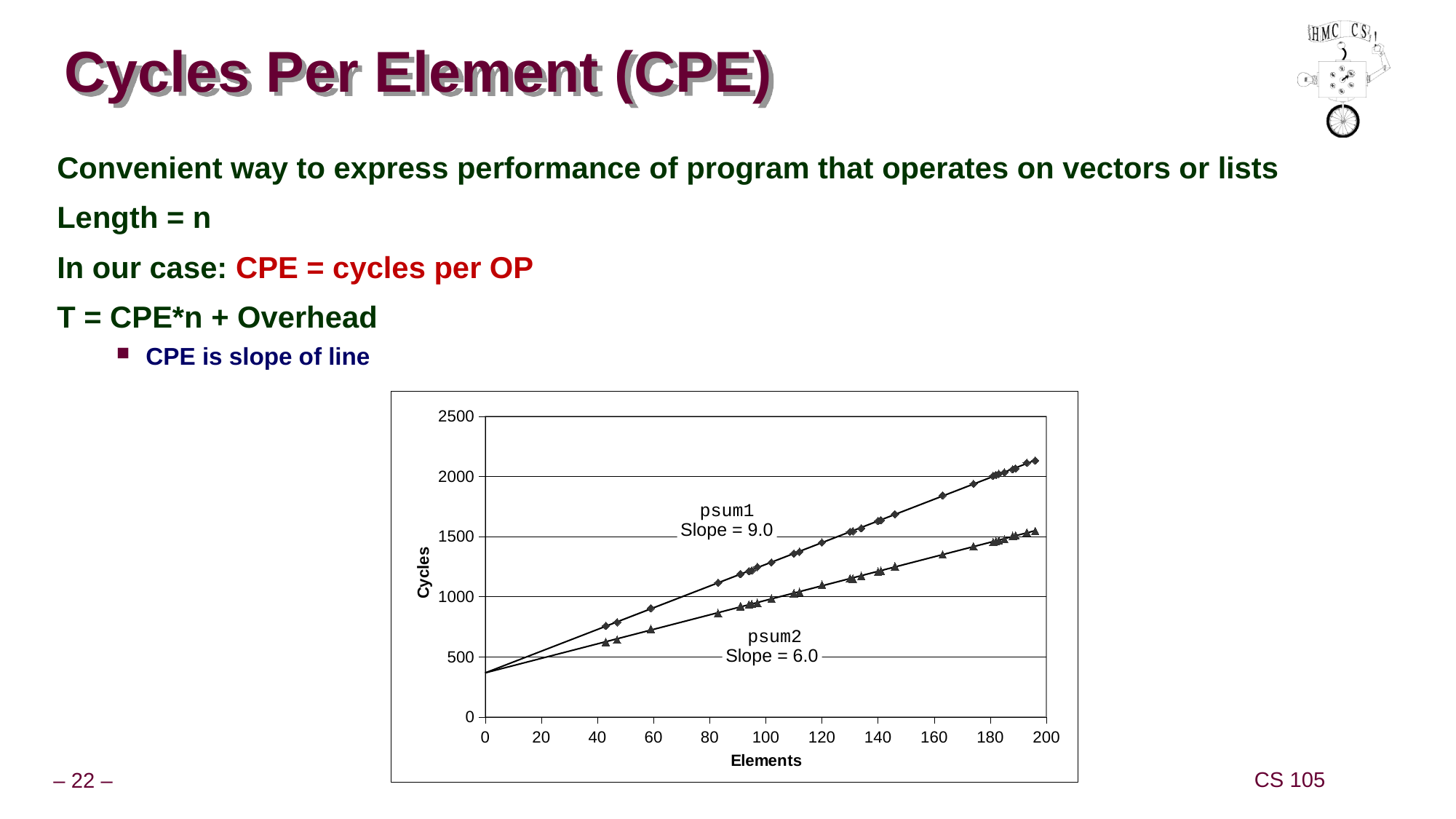
What is the difference between the printed slopes of psum1 and psum2? 3.0 What is the label on the y axis of the chart? Cycles What is the slope printed for the psum2 series? 6.0 What kind of chart is shown on the slide? scatter plot At 160 elements, which series has more cycles, psum1 or psum2? psum1 Do the cycle counts rise or fall as the number of elements increases? rise Which series has the larger slope, psum1 or psum2? psum1 How many data series are plotted on the chart? 2 Is the psum2 value at about 195 elements greater or less than 2000 cycles? less What is the slope printed for the psum1 series? 9.0 What is the label on the x axis of the chart? Elements Is the psum1 value at about 195 elements greater or less than 2000 cycles? greater